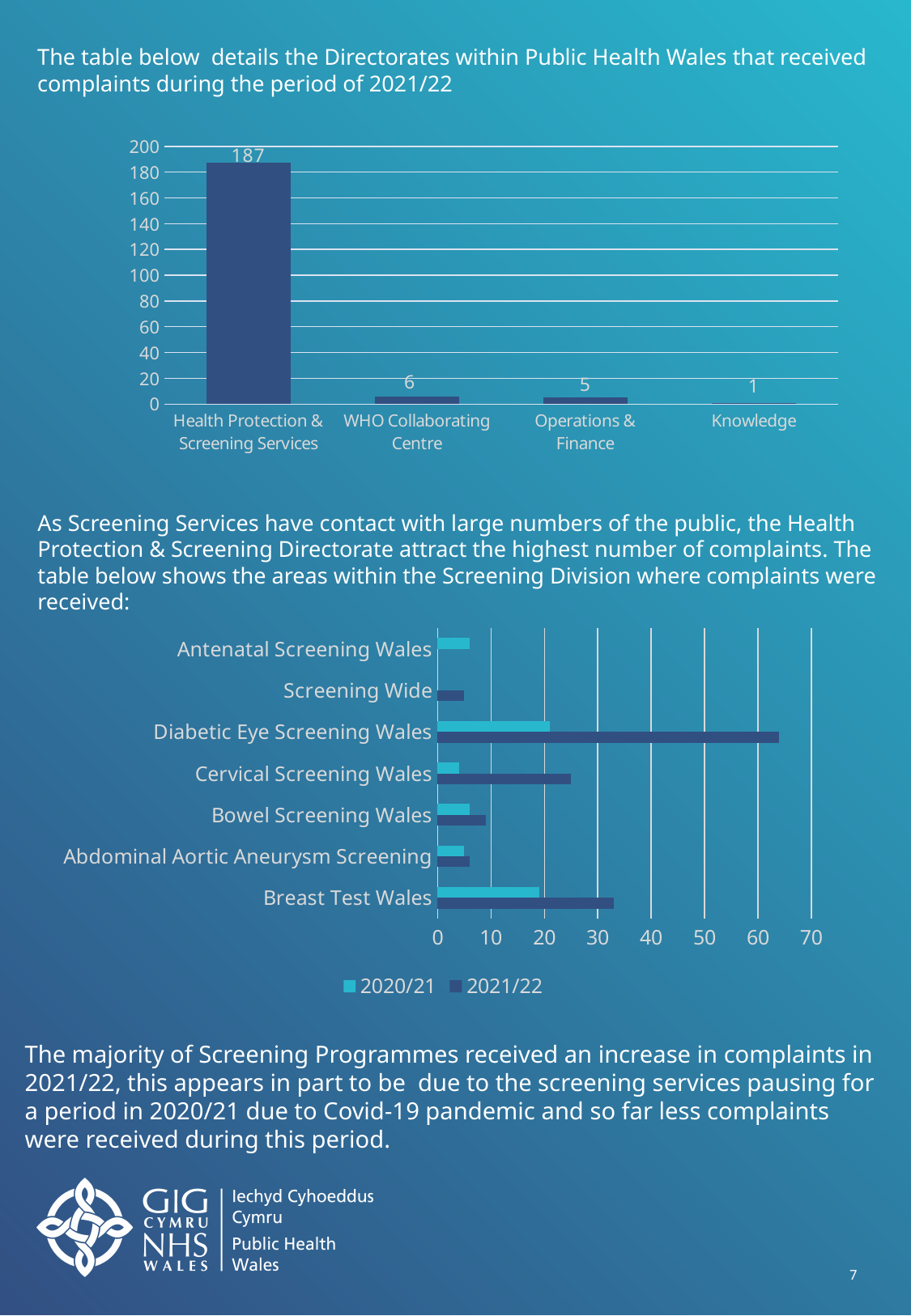
In the top chart, how many directorates are shown? 4 What type of chart is the top chart? Bar chart In the bottom chart, how many screening areas are shown? 7 In the top chart, how many complaints did Health Protection & Screening Services receive? 187 In the top chart, what is the value for Knowledge? 1 In the top chart, what is the difference between Health Protection & Screening Services and Operations & Finance? 182 In the bottom chart, how many series does the legend list? 2 In the bottom chart, which screening area has the highest 2021/22 value? Diabetic Eye Screening Wales In the bottom chart, is the 2021/22 value for Diabetic Eye Screening Wales greater or less than 60? greater In the top chart, what is the value for WHO Collaborating Centre? 6 In the bottom chart, for Breast Test Wales, which is larger: the 2020/21 value or the 2021/22 value? 2021/22 In the top chart, which directorate received the fewest complaints? Knowledge